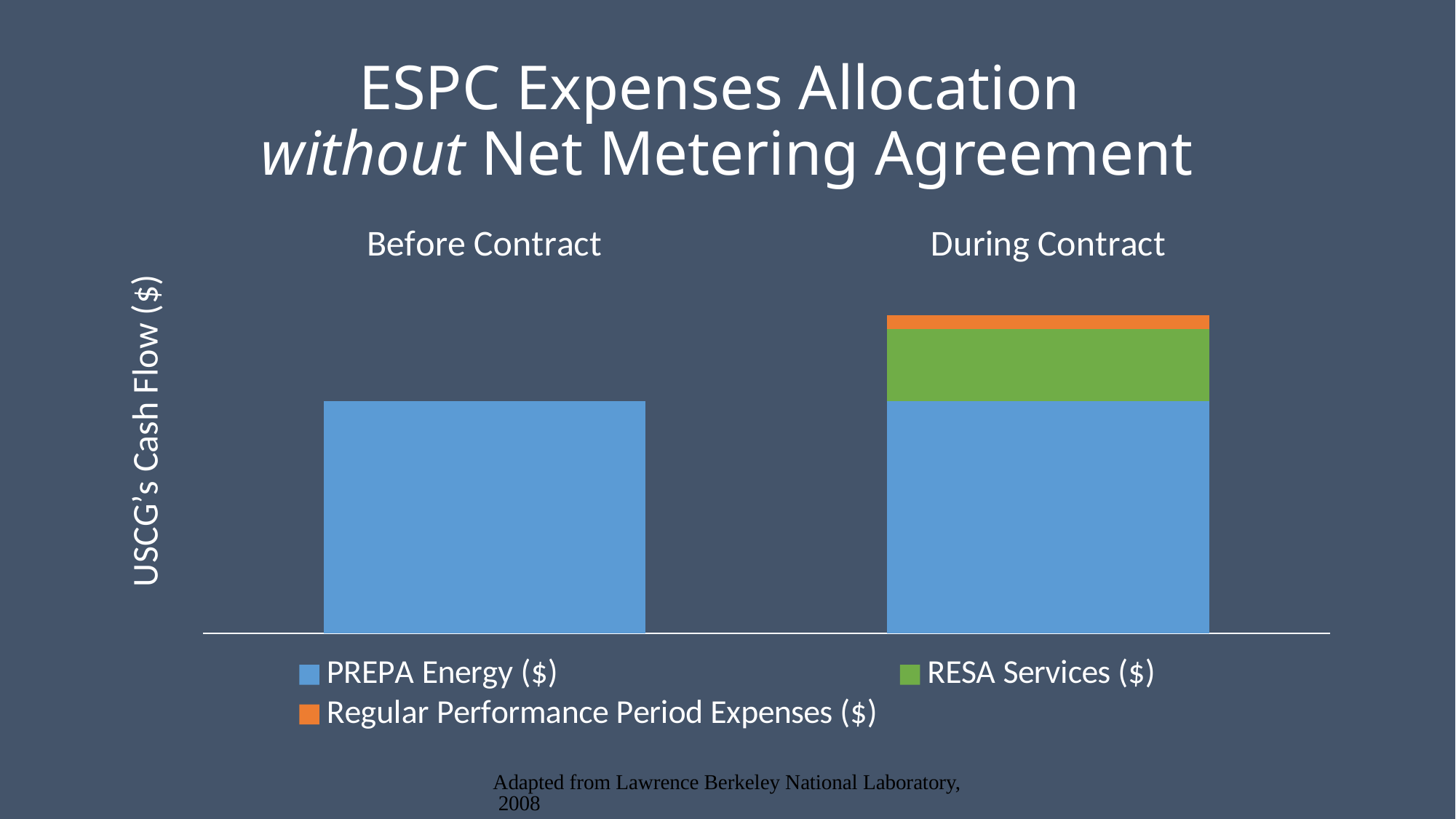
Which series is the smallest segment in the During Contract bar? Regular Performance Period Expenses ($) What is the label on the chart's y axis? USCG's Cash Flow ($) Which category has the highest total bar height? During Contract In the During Contract bar, which segment is larger: RESA Services ($) or Regular Performance Period Expenses ($)? RESA Services ($) Which series is the only one present in the Before Contract bar? PREPA Energy ($) Which category has the lowest total bar height? Before Contract Which category has the taller total bar, Before Contract or During Contract? During Contract How many categories are shown on the x axis of the chart? 2 Which colour represents RESA Services ($) in the chart? Green Does the total cash flow rise or fall from Before Contract to During Contract? Rise What kind of chart is shown on the slide? Stacked bar chart How many series does the chart's legend list? 3